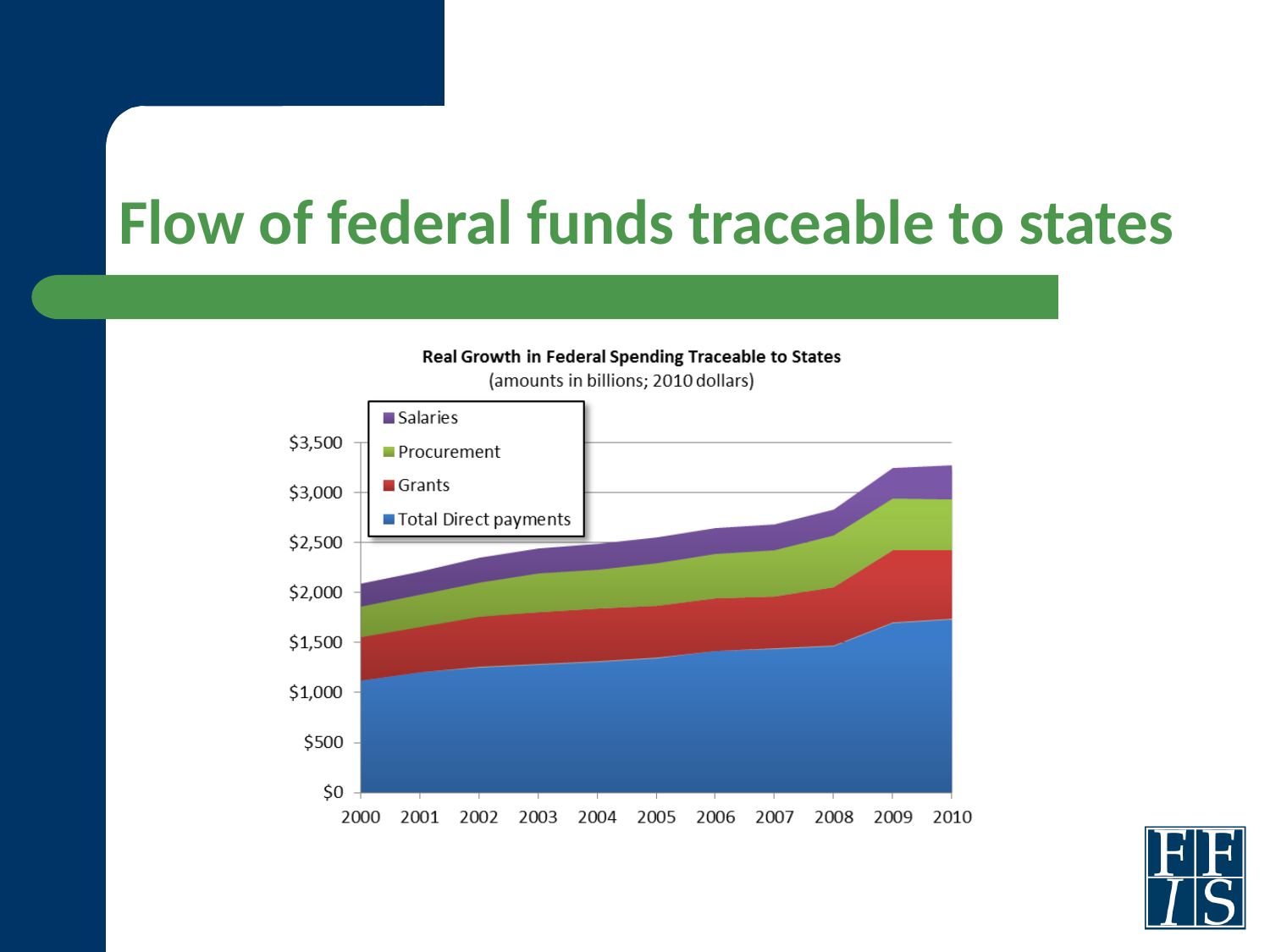
How many years are plotted along the x axis? 11 Is the value for Total Direct payments in 2000 greater or less than $1,000? greater What is the title of the chart? Real Growth in Federal Spending Traceable to States Which series is shown in blue at the bottom of the stack? Total Direct payments In which year is the total stacked spending lowest? 2000 Is the value for Total Direct payments in 2010 greater or less than $1,500? greater Is the total stacked spending in 2008 greater or less than $3,000? less Does total federal spending traceable to states rise or fall from 2000 to 2010? Rise How many series does the chart's legend list? 4 What kind of chart is shown on the slide? Stacked area chart In which year is the total stacked spending highest? 2010